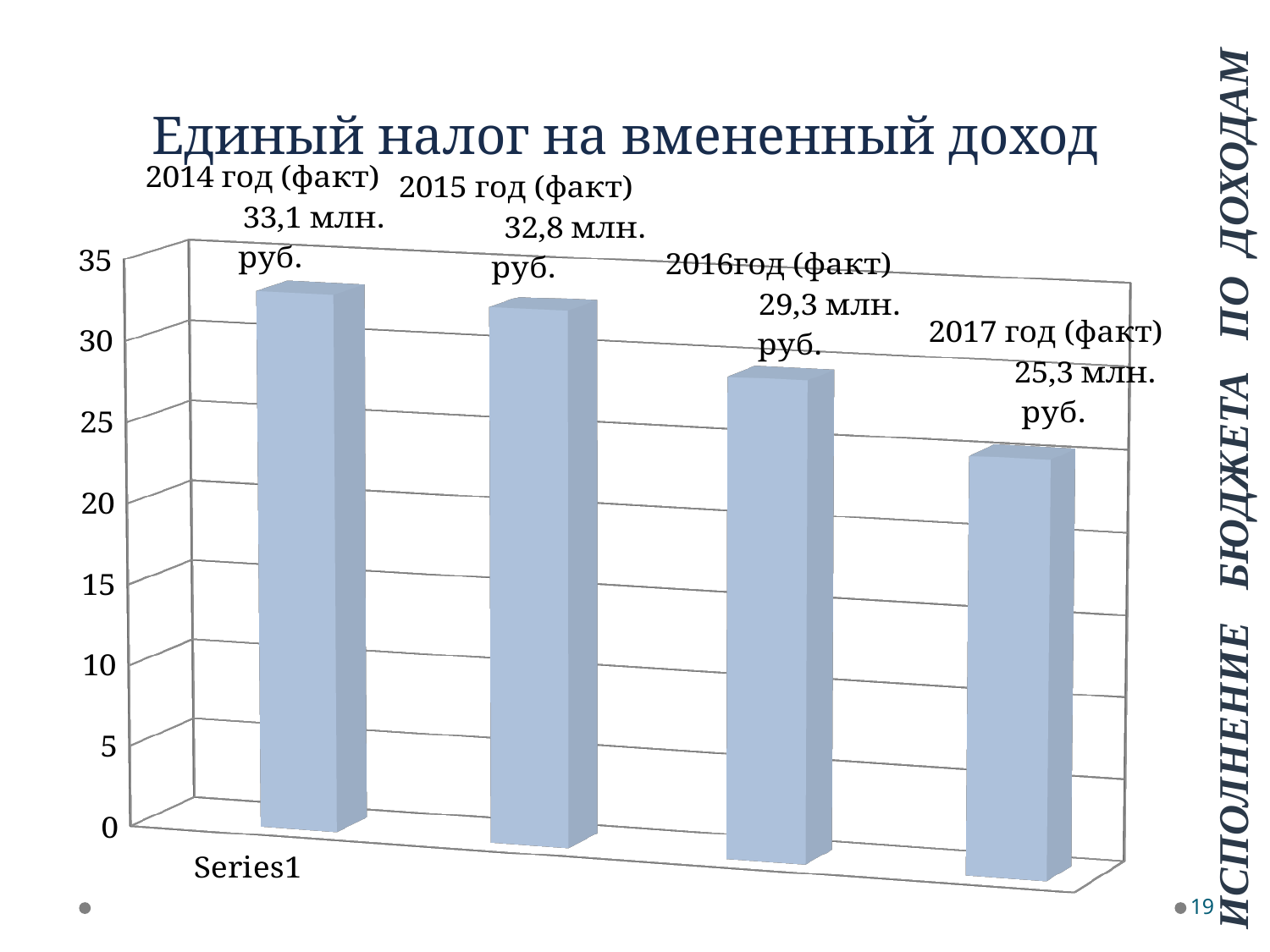
What is the value for 2014 год (факт)? 33,1 млн. руб. Do the values rise or fall from 2014 to 2017? fall Which year has the lowest value? 2017 год (факт) Is the value for 2016год (факт) greater or less than 30? less What kind of chart is shown on the slide? bar chart What is the difference between the values for 2014 год (факт) and 2017 год (факт)? 7,8 млн. руб. What is the value for 2017 год (факт)? 25,3 млн. руб. What is the value for 2016год (факт)? 29,3 млн. руб. What is the value for 2015 год (факт)? 32,8 млн. руб. How many bars are shown in the chart? 4 Which year has the highest value? 2014 год (факт) Which is larger, the value for 2016год (факт) or 2017 год (факт)? 2016год (факт)